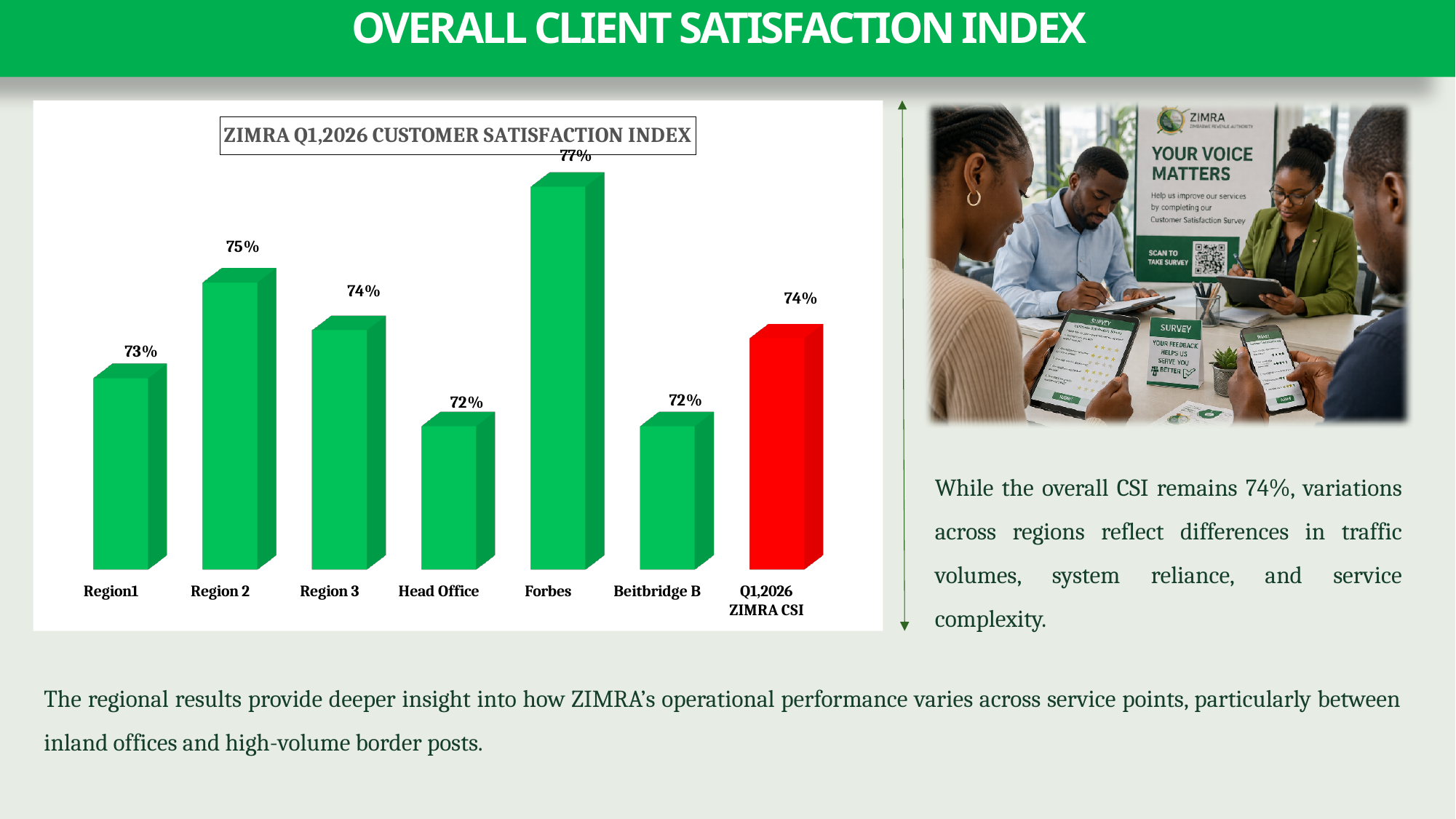
What is the value shown for Q1,2026 ZIMRA CSI? 74% What is the difference between the values for Forbes and Beitbridge B? 5% What is the difference between the values for Region 2 and Region1? 2% What kind of chart is shown on the slide? Bar chart Which category has the highest customer satisfaction index? Forbes How many categories are shown on the x axis of the chart? 7 Which is larger, the value for Region 3 or the value for Head Office? Region 3 What is the value shown for Head Office? 72% What is the title of the chart? ZIMRA Q1,2026 CUSTOMER SATISFACTION INDEX What is the customer satisfaction index value for Forbes? 77% What is the customer satisfaction index value for Region 2? 75% Which bar in the chart is coloured red? Q1,2026 ZIMRA CSI